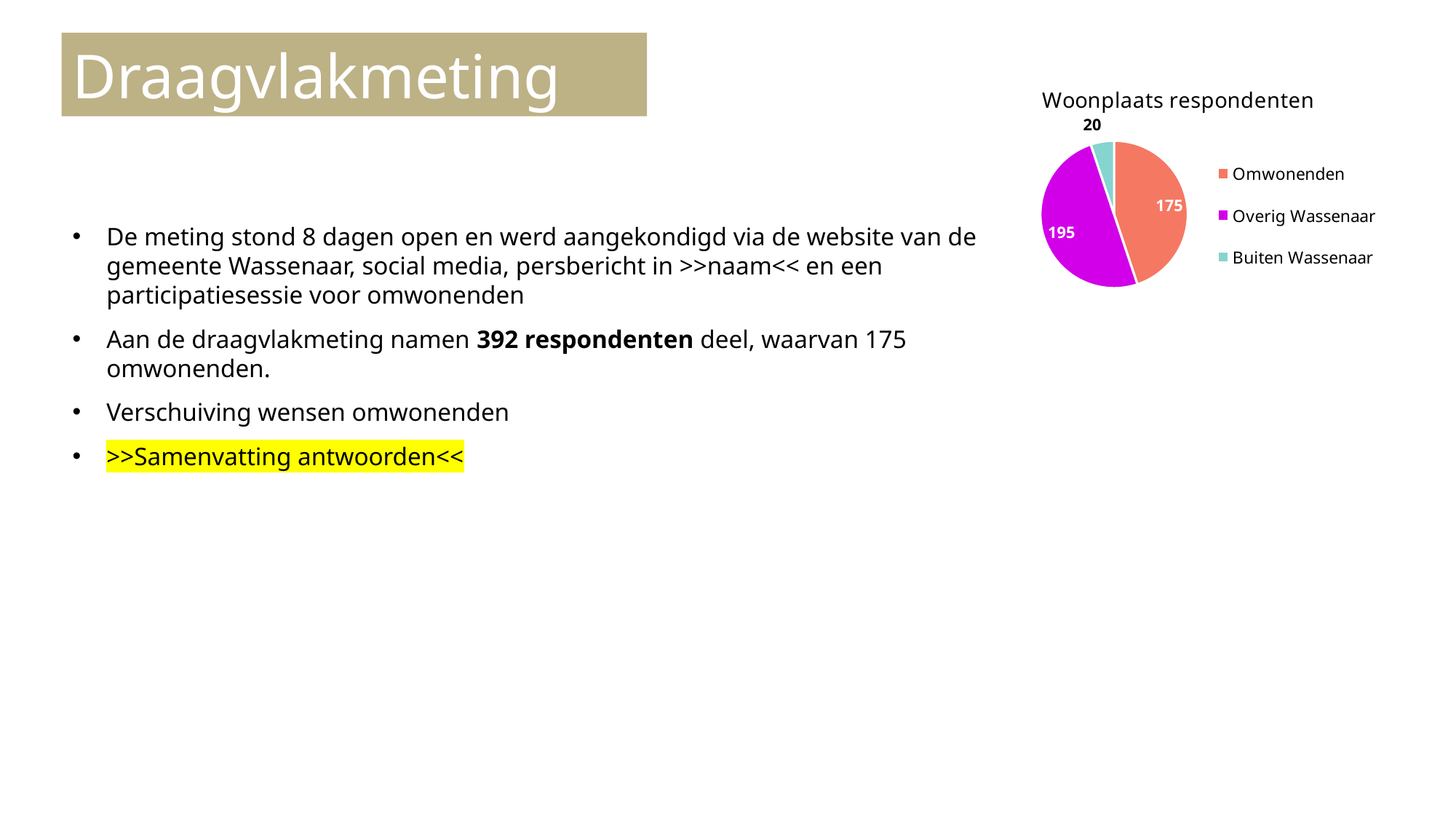
How many categories does the Woonplaats respondenten pie chart show? 3 What is the value for Buiten Wassenaar in the Woonplaats respondenten pie chart? 20 Which is larger in the pie chart, Omwonenden or Buiten Wassenaar? Omwonenden What is the title of the chart on the slide? Woonplaats respondenten Which category has the largest slice in the Woonplaats respondenten pie chart? Overig Wassenaar Which category has the smallest slice in the Woonplaats respondenten pie chart? Buiten Wassenaar What is the value for Overig Wassenaar in the Woonplaats respondenten pie chart? 195 What is the difference between the values for Omwonenden and Buiten Wassenaar in the pie chart? 155 What is the value for Omwonenden in the Woonplaats respondenten pie chart? 175 What kind of chart is shown on the slide? Pie chart What is the difference between the values for Overig Wassenaar and Omwonenden in the pie chart? 20 What share of the pie chart total does Overig Wassenaar represent? 50%